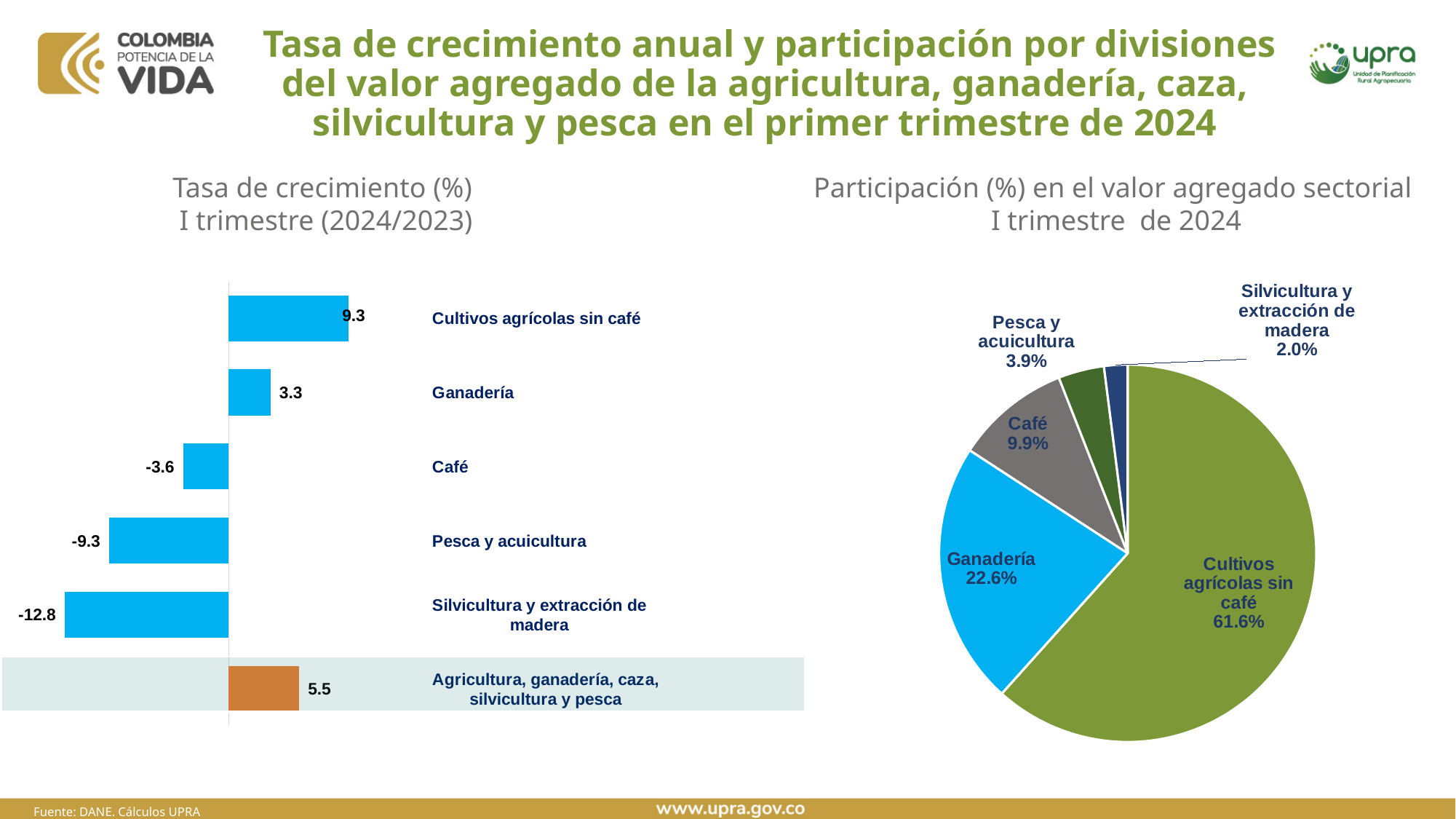
How many categories are shown in the 'Tasa de crecimiento (%) I trimestre (2024/2023)' chart? 6 In the 'Tasa de crecimiento (%) I trimestre (2024/2023)' chart, which category has the highest growth rate? Cultivos agrícolas sin café In the 'Tasa de crecimiento (%) I trimestre (2024/2023)' chart, what is the growth rate for Ganadería? 3.3 In the 'Tasa de crecimiento (%) I trimestre (2024/2023)' chart, which is larger: the growth rate for Café or for Pesca y acuicultura? Café In the 'Tasa de crecimiento (%) I trimestre (2024/2023)' chart, what is the growth rate for Silvicultura y extracción de madera? -12.8 In the 'Participación (%) en el valor agregado sectorial I trimestre de 2024' chart, what is the share of Ganadería? 22.6% What type of chart is the 'Tasa de crecimiento (%) I trimestre (2024/2023)' chart? Bar chart How many slices does the 'Participación (%) en el valor agregado sectorial I trimestre de 2024' pie chart have? 5 In the 'Tasa de crecimiento (%) I trimestre (2024/2023)' chart, what colour is the bar for Agricultura, ganadería, caza, silvicultura y pesca? Orange In the 'Participación (%) en el valor agregado sectorial I trimestre de 2024' chart, which division has the smallest share? Silvicultura y extracción de madera In the 'Tasa de crecimiento (%) I trimestre (2024/2023)' chart, which category has the lowest growth rate? Silvicultura y extracción de madera In the 'Tasa de crecimiento (%) I trimestre (2024/2023)' chart, what is the difference between the growth rate of Cultivos agrícolas sin café and Ganadería? 6.0